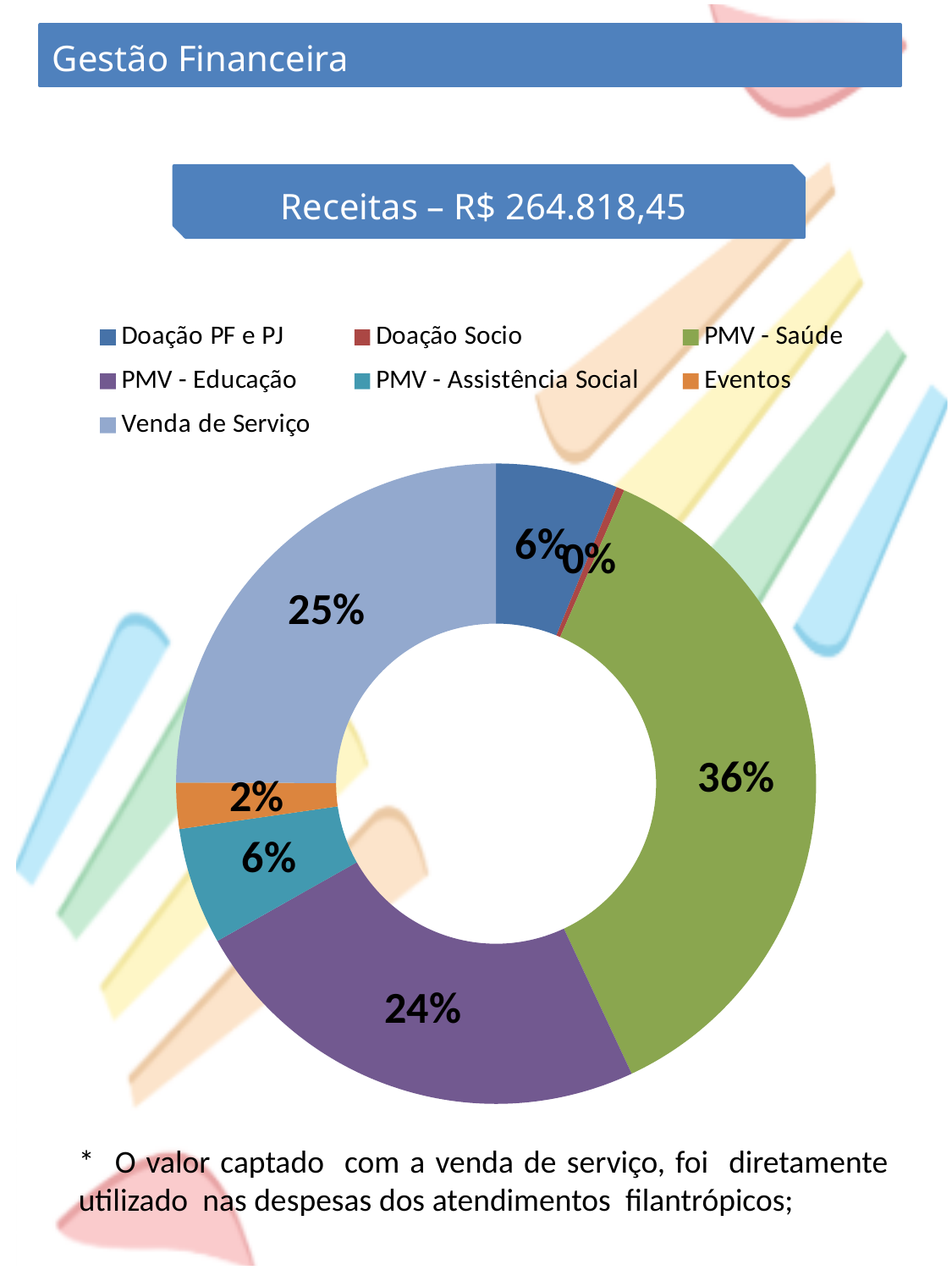
What share of receitas does PMV - Saúde account for? 36% What percentage is shown for Eventos? 2% What share of receitas does PMV - Educação account for? 24% How many categories does the legend list? 7 What percentage is shown for Doação Socio? 0% What kind of chart is shown on the slide? Doughnut (pie) chart Which category has the largest share of receitas? PMV - Saúde Which is larger, the share for Venda de Serviço or the share for PMV - Educação? Venda de Serviço What share of receitas does Venda de Serviço account for? 25% Which category has the smallest share of receitas? Doação Socio What is the difference in percentage points between PMV - Saúde and PMV - Educação? 12 What total amount of receitas is stated above the chart? R$ 264.818,45